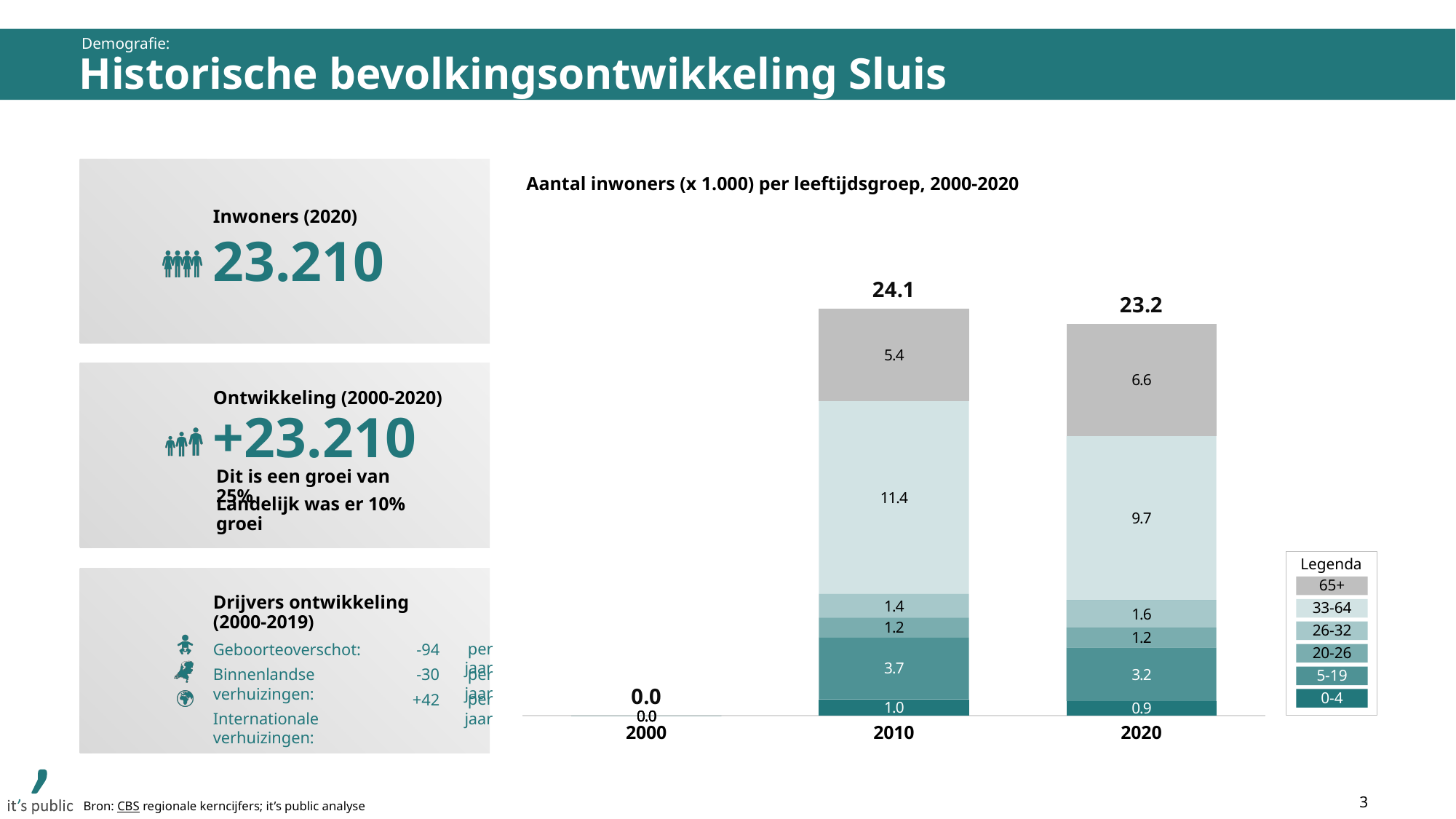
What is the value for the 33-64 age group in 2010? 11.4 Which year has the highest total number of inhabitants in the chart? 2010 What is the total value of the stacked bar for 2010? 24.1 What is the value for the 5-19 age group in 2020? 3.2 Which is larger: the 65+ value in 2010 or the 65+ value in 2020? 2020 What type of chart is shown on the slide? stacked bar chart What is the total value of the stacked bar for 2020? 23.2 How many age groups does the legend list? 6 What is the title of the chart? Aantal inwoners (x 1.000) per leeftijdsgroep, 2000-2020 What is the value for the 65+ age group in 2020? 6.6 How many years are shown on the x axis of the chart? 3 What is the difference between the 33-64 values for 2010 and 2020? 1.7